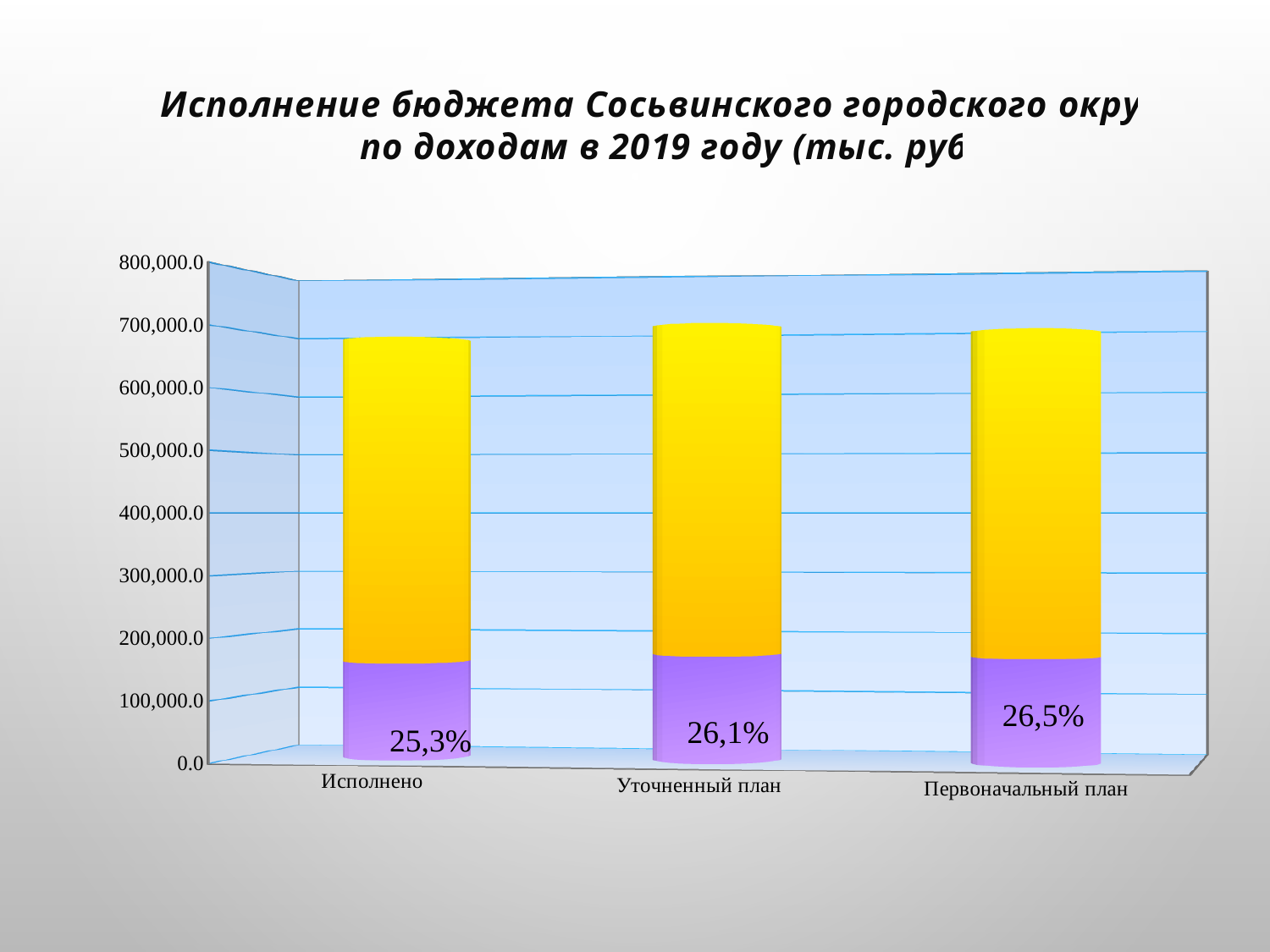
What percentage label is printed on the Исполнено bar? 25,3% Which bar has the lowest percentage label printed on it? Исполнено What year does the chart title say the budget execution refers to? 2019 What kind of chart is shown on the slide? bar chart Is the purple segment of the Уточненный план bar greater or less than 200,000.0? less How many categories are shown on the x axis of the chart? 3 What is the difference between the percentage labels on the Первоначальный план bar and the Исполнено bar? 1,2% What percentage label is printed on the Первоначальный план bar? 26,5% Which bar has the highest percentage label printed on it? Первоначальный план Which percentage label is larger: the one on the Уточненный план bar or the one on the Исполнено bar? Уточненный план Is the total height of the Исполнено bar greater or less than 600,000.0? greater What percentage label is printed on the Уточненный план bar? 26,1%